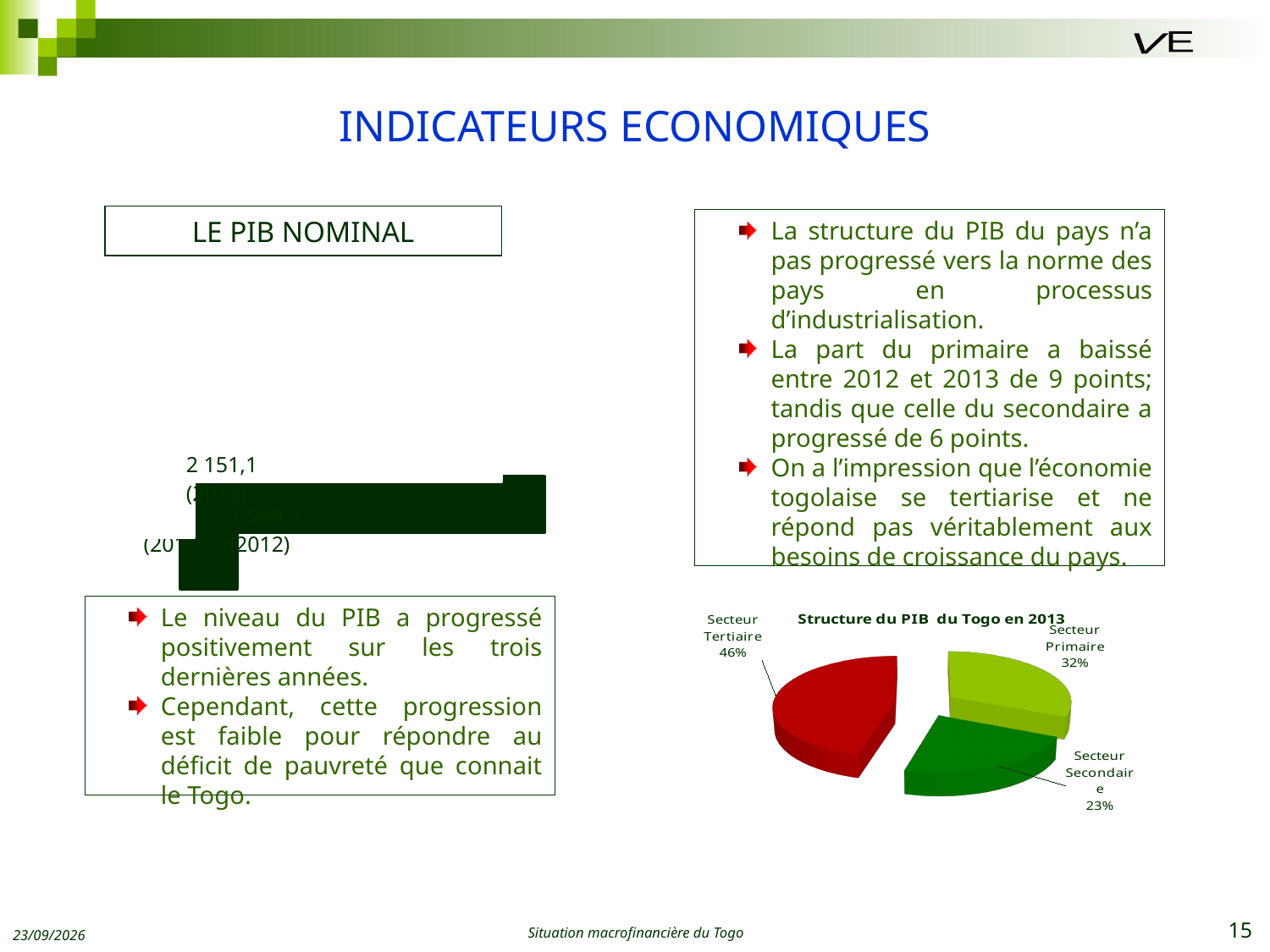
In the pie chart 'Structure du PIB du Togo en 2013', which sector has the smallest share? Secteur Secondaire In the pie chart 'Structure du PIB du Togo en 2013', how many percentage points larger is Secteur Primaire than Secteur Secondaire? 9 In the chart under 'LE PIB NOMINAL' on the left of the slide, what is the value labelled for 2013? 2 151,1 What kind of chart is the chart titled 'Structure du PIB du Togo en 2013'? Pie chart In the pie chart 'Structure du PIB du Togo en 2013', which sector has the largest share? Secteur Tertiaire In the pie chart 'Structure du PIB du Togo en 2013', what share does Secteur Primaire have? 32% In the pie chart 'Structure du PIB du Togo en 2013', how many percentage points larger is Secteur Tertiaire than Secteur Primaire? 14 How many slices does the pie chart 'Structure du PIB du Togo en 2013' have? 3 In the pie chart 'Structure du PIB du Togo en 2013', which is larger: Secteur Primaire or Secteur Secondaire? Secteur Primaire In the pie chart 'Structure du PIB du Togo en 2013', what share does Secteur Secondaire have? 23% In the pie chart 'Structure du PIB du Togo en 2013', what colour is the Secteur Tertiaire slice? Red In the pie chart 'Structure du PIB du Togo en 2013', what share does Secteur Tertiaire have? 46%